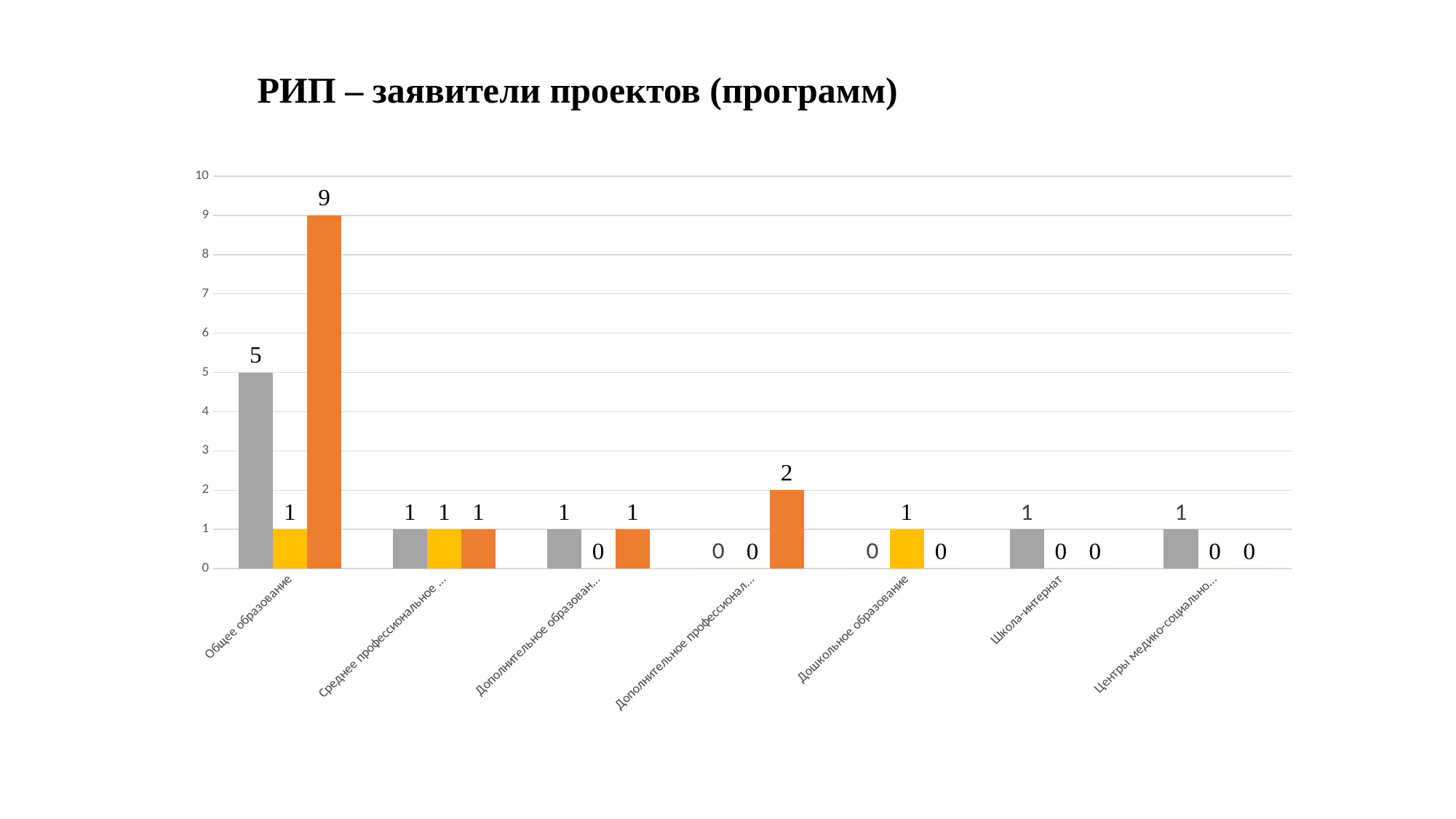
What is the value of the orange bar for Дополнительное профессионал...? 2 What type of chart is shown on the slide? bar chart What is the total of the three bars for Среднее профессиональное ...? 3 Which is larger for Общее образование: the grey bar or the yellow bar? the grey bar What is the value of the grey bar for Общее образование? 5 How many categories are shown on the x axis of the chart? 7 What is the value of the yellow bar for Дошкольное образование? 1 Which category has the highest bar in the chart? Общее образование What is the value of the grey bar for Школа-интернат? 1 What is the difference between the orange bar and the grey bar for Общее образование? 4 What is the value of the orange bar for Общее образование? 9 What is the title of the chart? РИП – заявители проектов (программ)